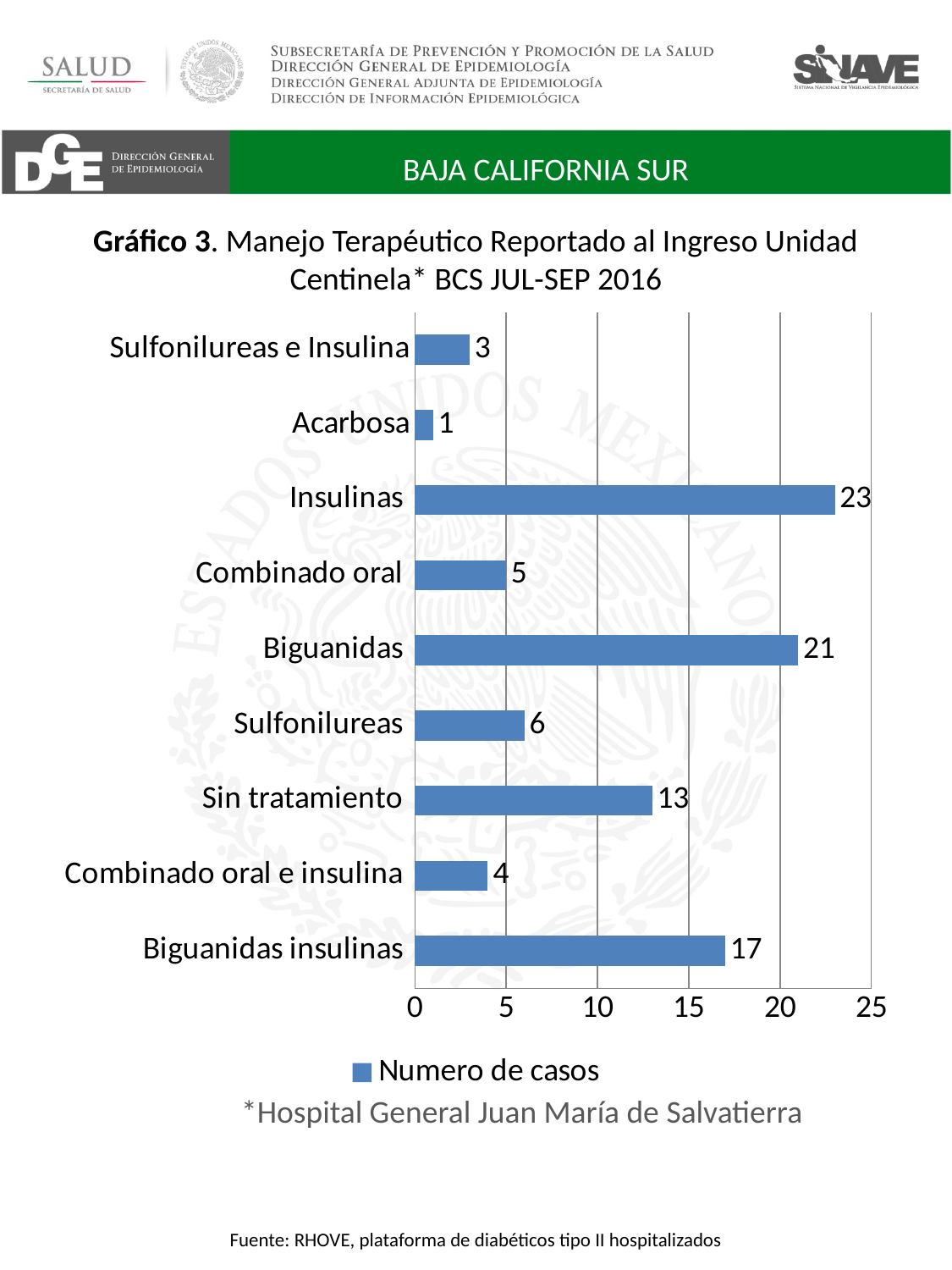
Which category has the lowest number of cases? Acarbosa What is the number of cases for Biguanidas insulinas? 17 What kind of chart is shown on the slide? Bar chart What is the number of cases for Sin tratamiento? 13 Which category has the highest number of cases? Insulinas How many categories are shown in the chart? 9 What is the difference in number of cases between Biguanidas insulinas and Sin tratamiento? 4 What is the number of cases for Insulinas? 23 Is the value for Biguanidas greater or less than 20? greater What is the difference in number of cases between Insulinas and Biguanidas? 2 Which has more cases, Sulfonilureas or Combinado oral? Sulfonilureas What series name does the legend show? Numero de casos